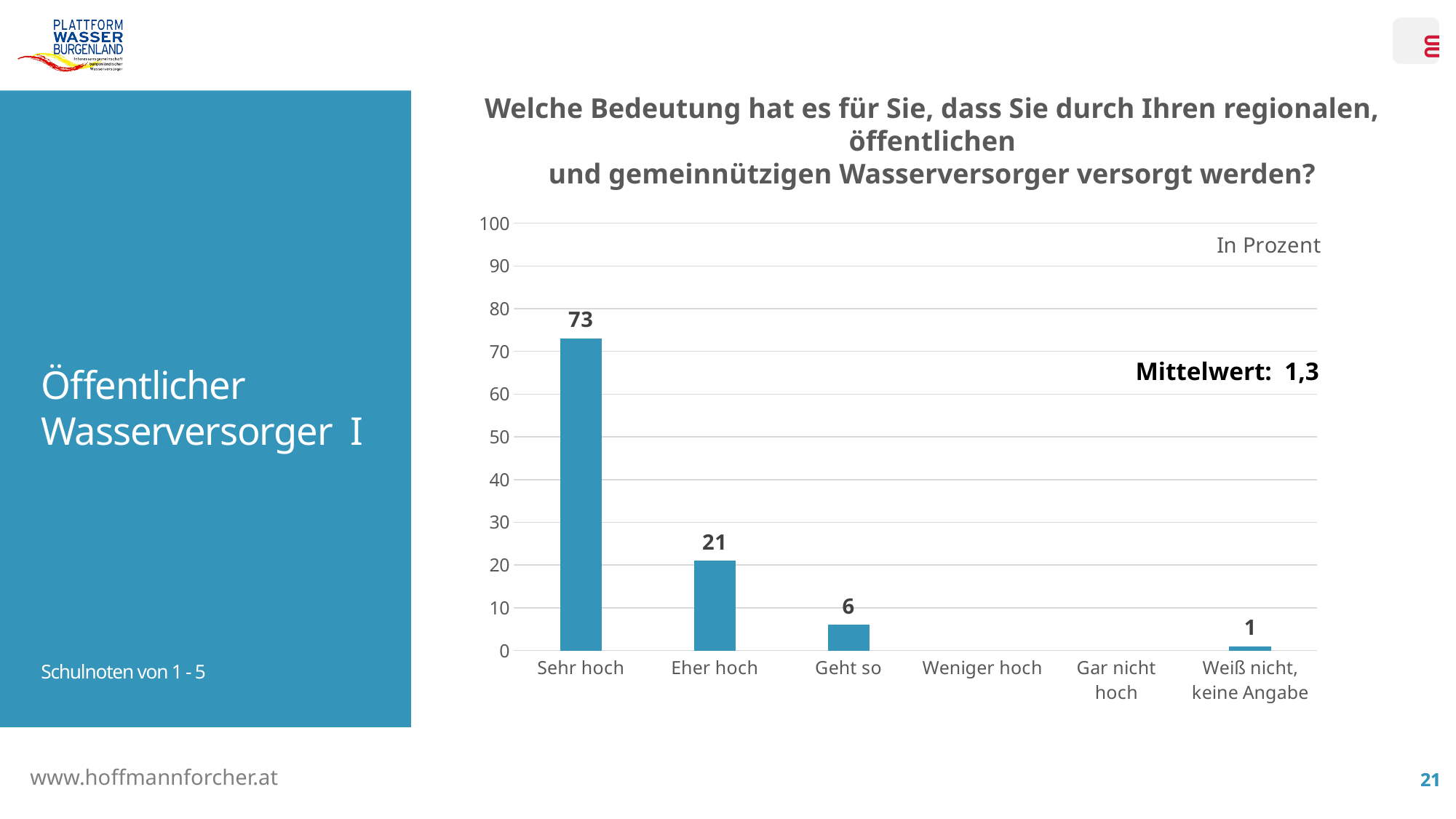
What is the value for "Weiß nicht, keine Angabe"? 1 What kind of chart is shown on the slide? bar chart How many categories are shown on the x axis? 6 Which is larger, the value for "Eher hoch" or the value for "Geht so"? Eher hoch What is the Mittelwert (mean value) shown on the chart? 1,3 Which category has the highest value? Sehr hoch What is the value for "Eher hoch"? 21 Is the value for "Sehr hoch" greater or less than 70? greater What is the difference between the values for "Sehr hoch" and "Eher hoch"? 52 In what unit are the values shown, according to the label on the chart? In Prozent What is the value for "Geht so"? 6 What is the value for "Sehr hoch"? 73